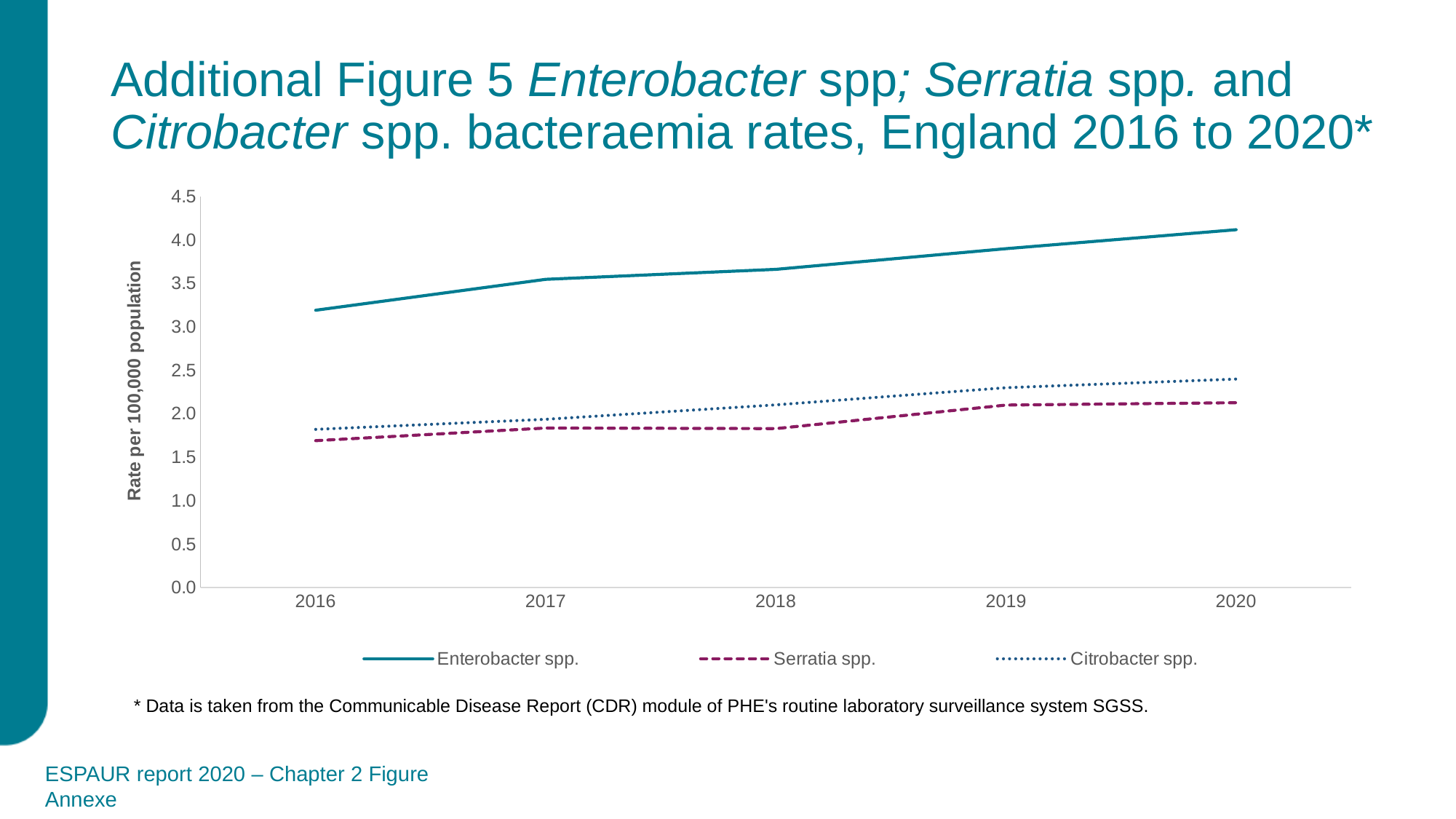
Is the Serratia spp. rate in 2016 greater or less than 2.0? less Does the Enterobacter spp. rate rise or fall from 2016 to 2020? rise What kind of chart is shown on the slide? line chart How many years are plotted along the x axis? 5 In 2018, which is larger: the Citrobacter spp. rate or the Serratia spp. rate? Citrobacter spp. Which series has the lowest rate in 2016? Serratia spp. Is the Citrobacter spp. rate in 2020 greater or less than 2.5? less Is the Enterobacter spp. rate in 2016 greater or less than 3.0? greater What is the label on the y axis? Rate per 100,000 population How many series does the legend list? 3 Which series has the highest rate in 2020? Enterobacter spp.